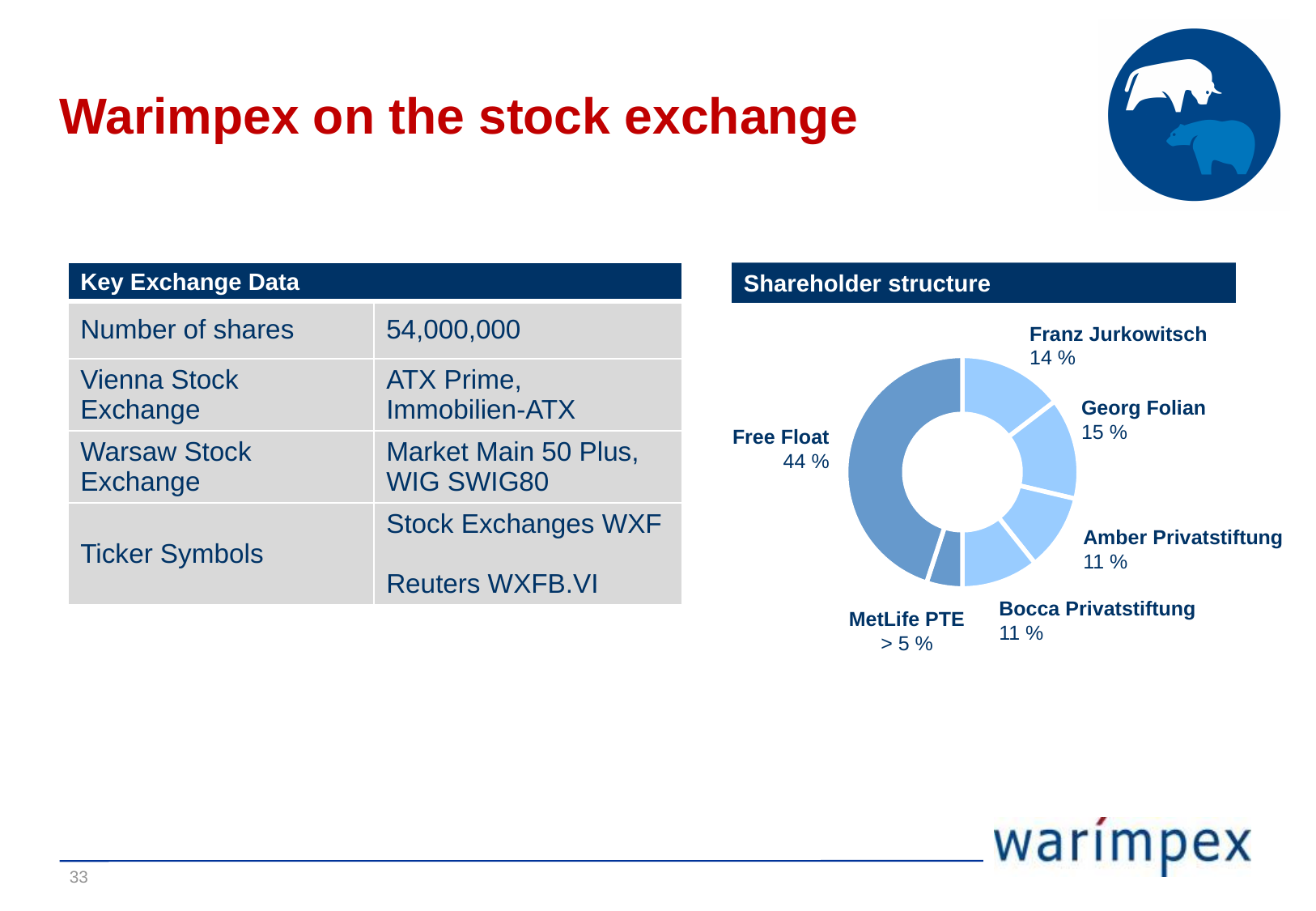
What percentage does Georg Folian hold in the Shareholder structure chart? 15 % What percentage does Franz Jurkowitsch hold in the Shareholder structure chart? 14 % In the Shareholder structure chart, how much larger is Georg Folian's share than Franz Jurkowitsch's? 1 % Which shareholder group has the largest slice in the Shareholder structure chart? Free Float What value is shown for MetLife PTE in the Shareholder structure chart? > 5 % What share of Warimpex is held as Free Float according to the Shareholder structure chart? 44 % Which shareholder has the smallest slice in the Shareholder structure chart? MetLife PTE In the Shareholder structure chart, who holds more: Free Float or Georg Folian? Free Float What kind of chart is used for the Shareholder structure? Pie (donut) chart What share is attributed to Amber Privatstiftung in the Shareholder structure chart? 11 % What share is attributed to Bocca Privatstiftung in the Shareholder structure chart? 11 % How many shareholder categories are shown in the Shareholder structure chart? 6